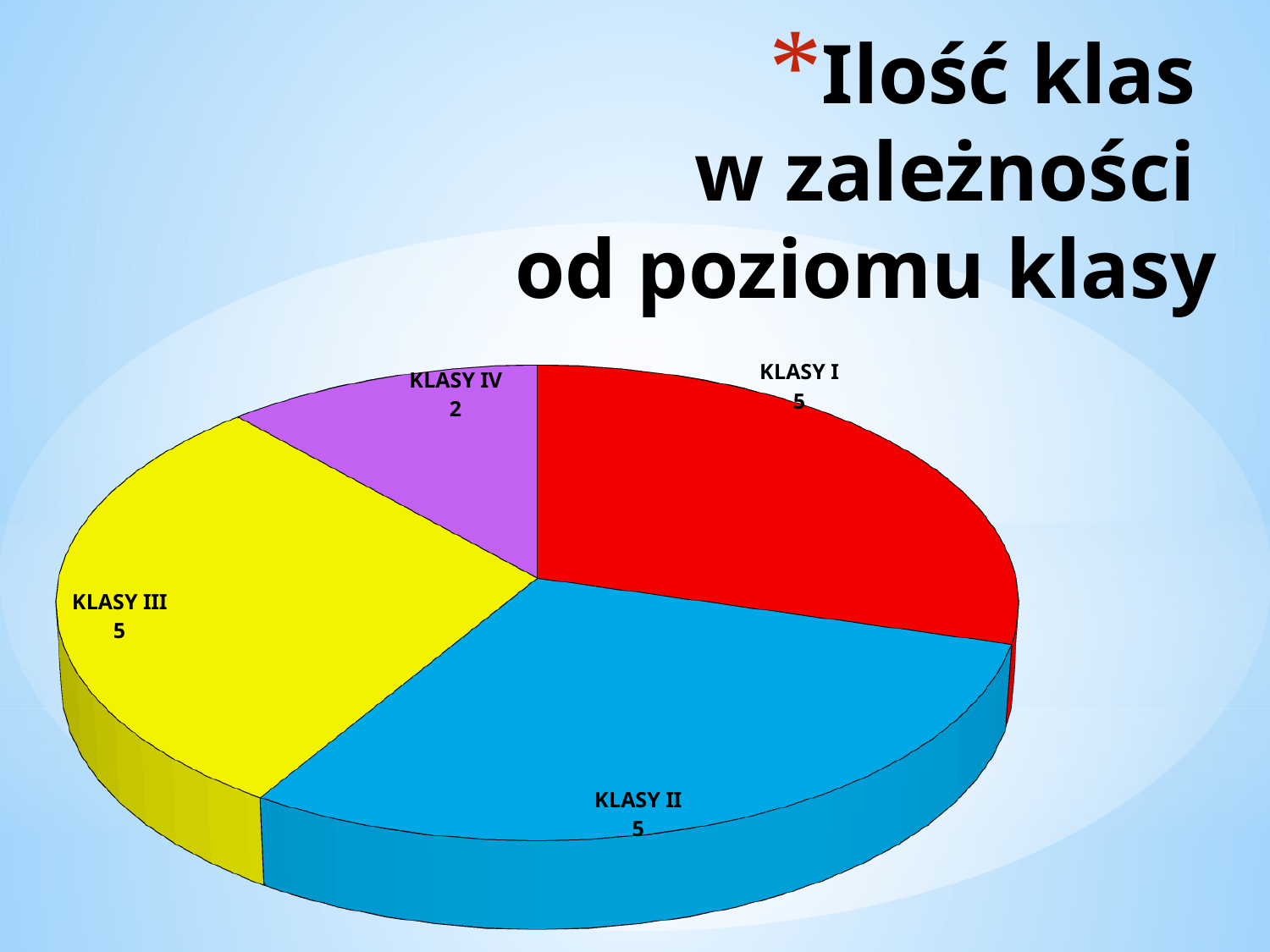
What is the value for KLASY I? 5 What is the difference between the values for KLASY I and KLASY IV? 3 How many slices does the pie chart have? 4 Which category has the smallest slice? KLASY IV What is the value for KLASY II? 5 Which is larger, the value for KLASY II or the value for KLASY IV? KLASY II What is the title of the slide containing the chart? Ilość klas w zależności od poziomu klasy What is the value for KLASY III? 5 What is the value for KLASY IV? 2 What kind of chart is shown on the slide? pie chart What colour is the KLASY III slice? yellow